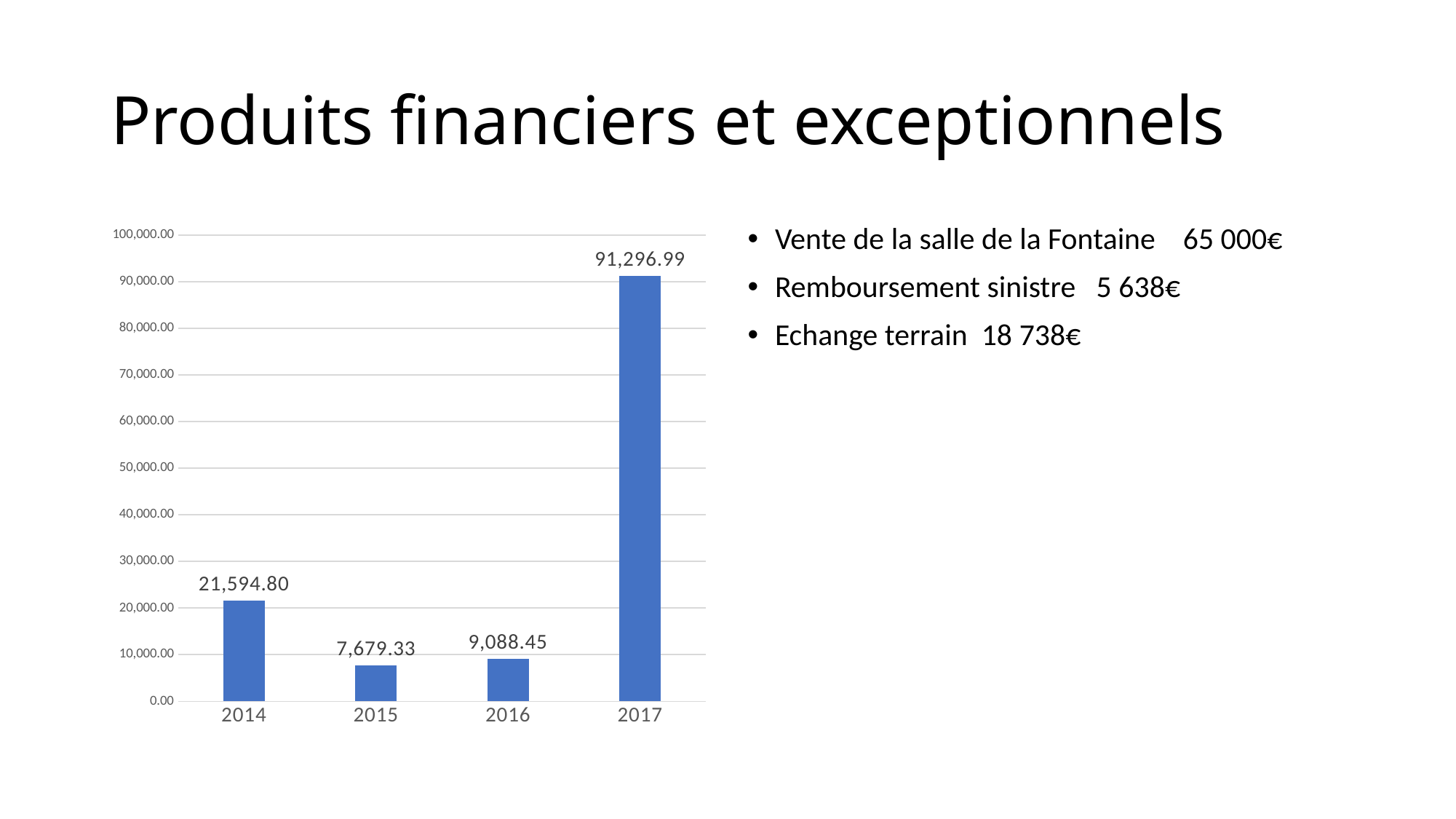
Is the value for 2017 greater or less than 90,000.00? greater What is the value for 2014? 21,594.80 What is the value for 2016? 9,088.45 Which is larger, the value for 2014 or the value for 2016? 2014 How many years are shown on the x axis? 4 What is the difference between the values for 2016 and 2015? 1,409.12 Which year has the highest value? 2017 What kind of chart is shown on the slide? bar chart What is the value for 2017? 91,296.99 What is the difference between the values for 2017 and 2014? 69,702.19 What is the value for 2015? 7,679.33 Which year has the lowest value? 2015